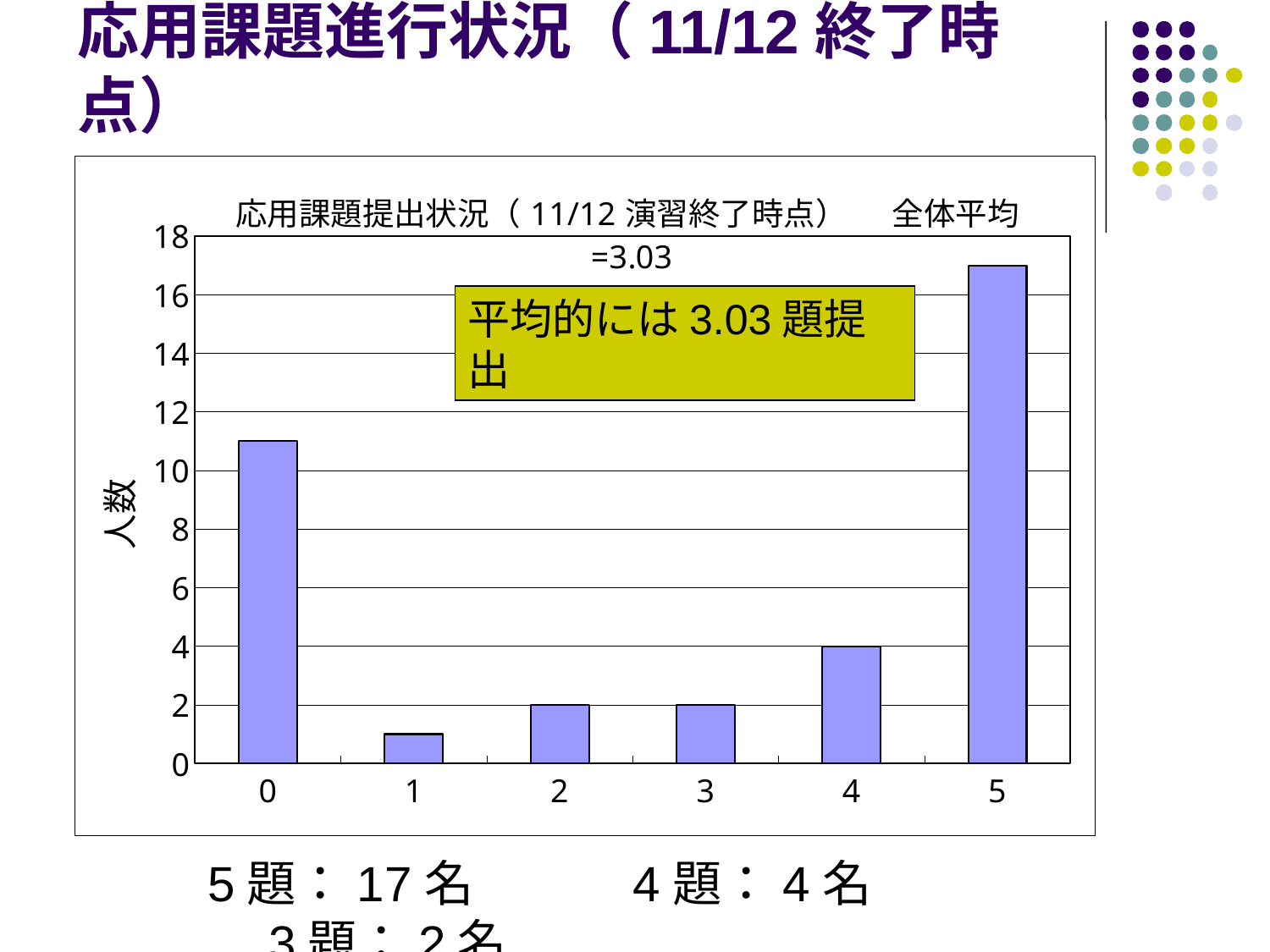
What is the label of the y axis of the chart? 人数 What is the value (人数) for category 2? 2 What is the value (人数) for category 4? 4 What is the value (人数) for category 3? 2 What is the value (人数) for category 5? 17 Is the value for category 0 greater or less than 10? greater Which category has the highest bar in the chart? 5 What is the difference between the values for category 5 and category 4? 13 How many categories are shown on the x axis of the chart? 6 Which category has the lowest bar in the chart? 1 What kind of chart is shown on the slide? bar chart Which is larger, the value for category 0 or the value for category 5? 5